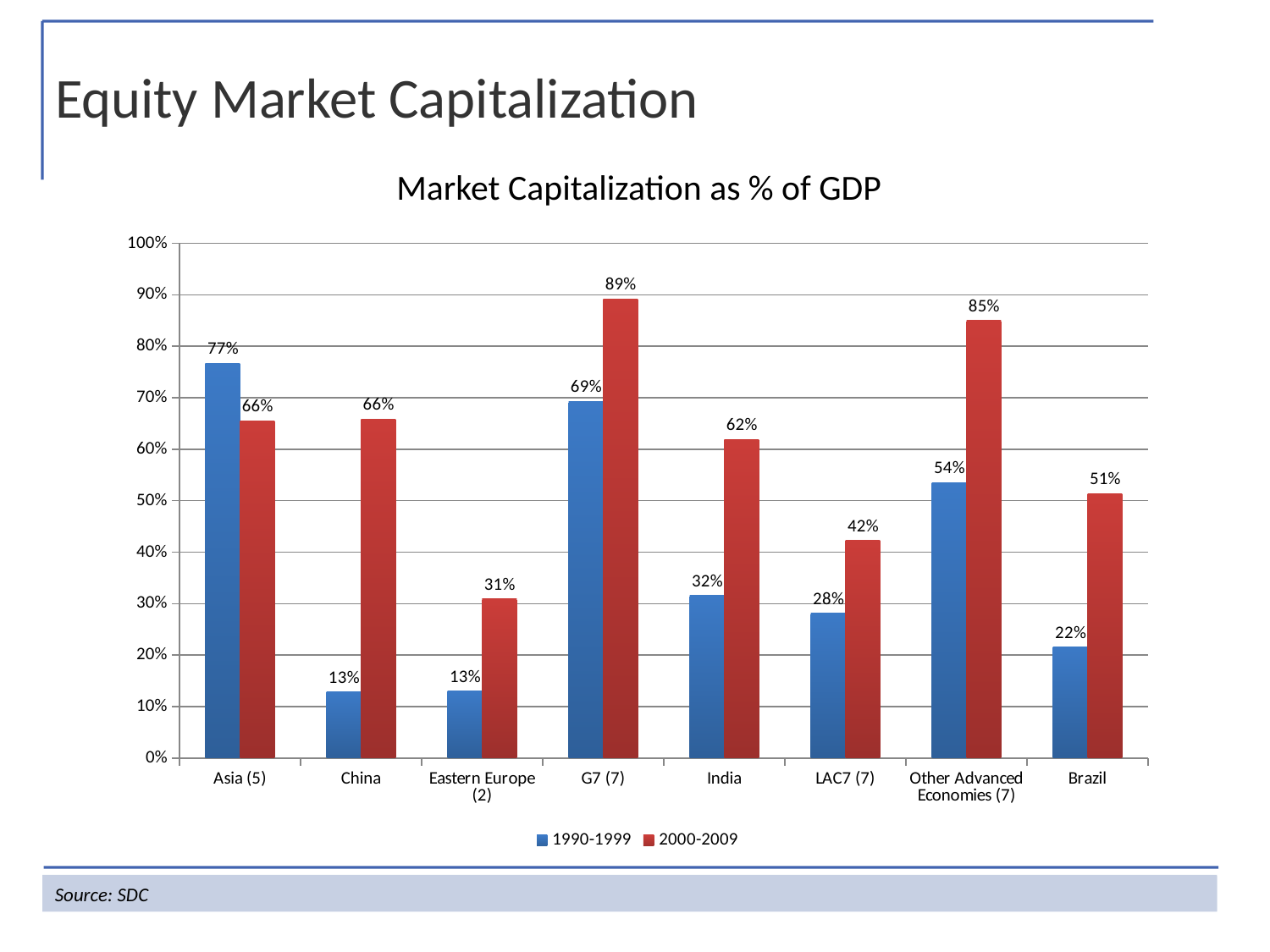
How many categories are shown on the x axis? 8 What is the 2000-2009 value for G7 (7)? 89% Which category has the lowest 2000-2009 value? Eastern Europe (2) What kind of chart is shown? Bar chart What is the difference between the 2000-2009 and 1990-1999 values for China? 53% For Asia (5), which is larger: the 1990-1999 value or the 2000-2009 value? 1990-1999 What is the 2000-2009 value for Brazil? 51% What is the 1990-1999 value for India? 32% How many series does the legend list? 2 What is the title of the chart? Market Capitalization as % of GDP What is the difference between the 2000-2009 and 1990-1999 values for Other Advanced Economies (7)? 31% Which category has the highest 2000-2009 value? G7 (7)